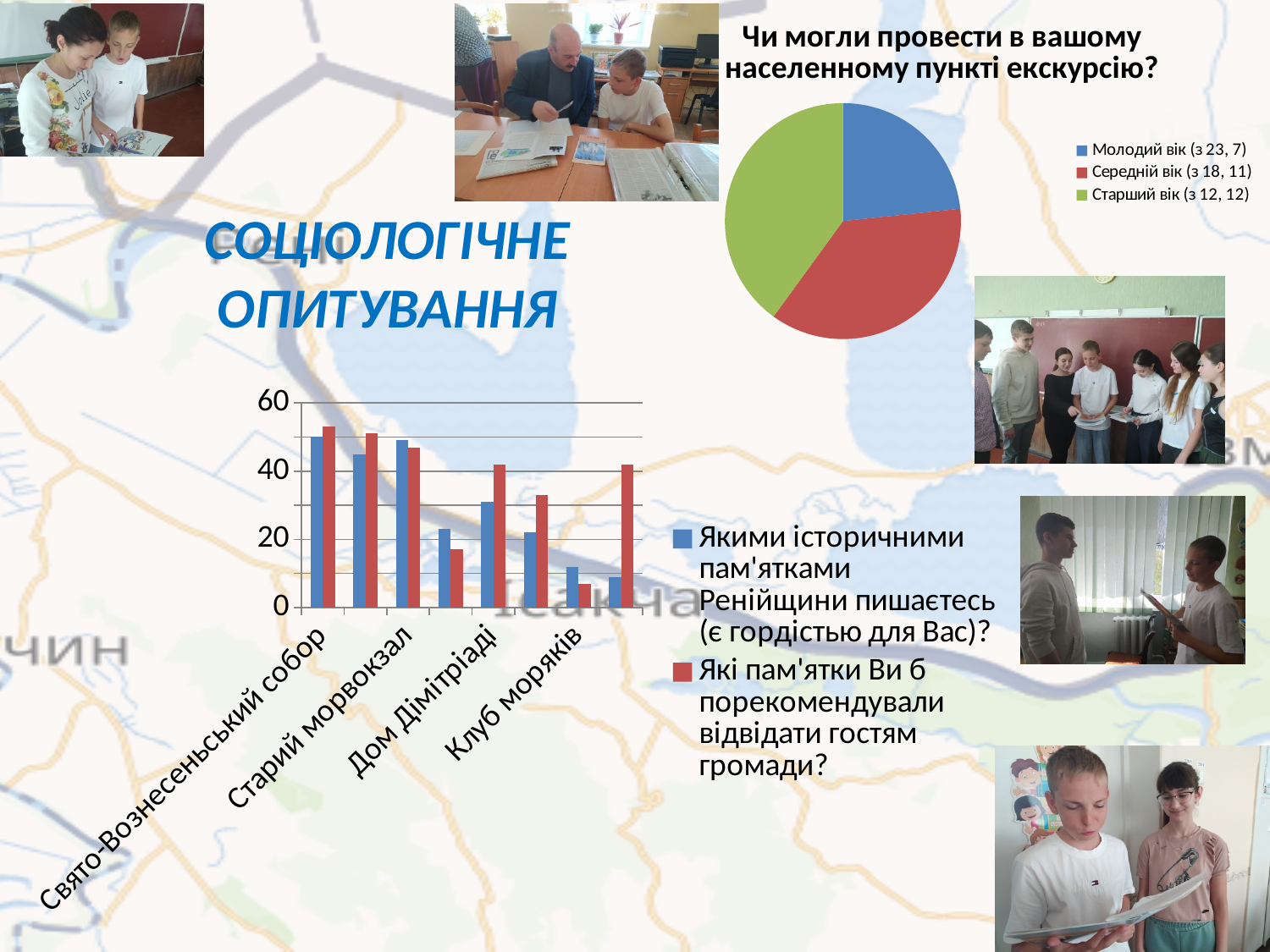
In the bar chart at the bottom left, is the red value (Які пам'ятки Ви б порекомендували відвідати гостям громади) for Клуб моряків greater or less than 20? less In the bar chart at the bottom left, is the blue value (Якими історичними пам'ятками Ренійщини пишаєтесь) for Свято-Вознесенський собор greater or less than 40? greater In the bar chart at the bottom left, do the blue bars generally rise or fall from left to right along the x axis? fall What kind of chart is the chart titled "Чи могли провести в вашому населенному пункті екскурсію?"? pie chart In the bar chart at the bottom left, for Дом Дімітріаді, which bar is taller: the blue one or the red one? the red one What kind of chart is the chart at the bottom left of the slide with categories such as Свято-Вознесенський собор and Клуб моряків? bar chart How many series does the legend of the bar chart at the bottom left of the slide list? 2 In the pie chart "Чи могли провести в вашому населенному пункті екскурсію?", what colour is the slice for Старший вік (з 12, 12)? green In the pie chart "Чи могли провести в вашому населенному пункті екскурсію?", which age group has the smallest slice? Молодий вік (з 23, 7) In the pie chart "Чи могли провести в вашому населенному пункті екскурсію?", which slice is larger: Старший вік (з 12, 12) or Молодий вік (з 23, 7)? Старший вік (з 12, 12) In the bar chart at the bottom left, is the blue value for Дом Дімітріаді greater or less than 20? greater How many entries does the legend of the pie chart "Чи могли провести в вашому населенному пункті екскурсію?" list? 3